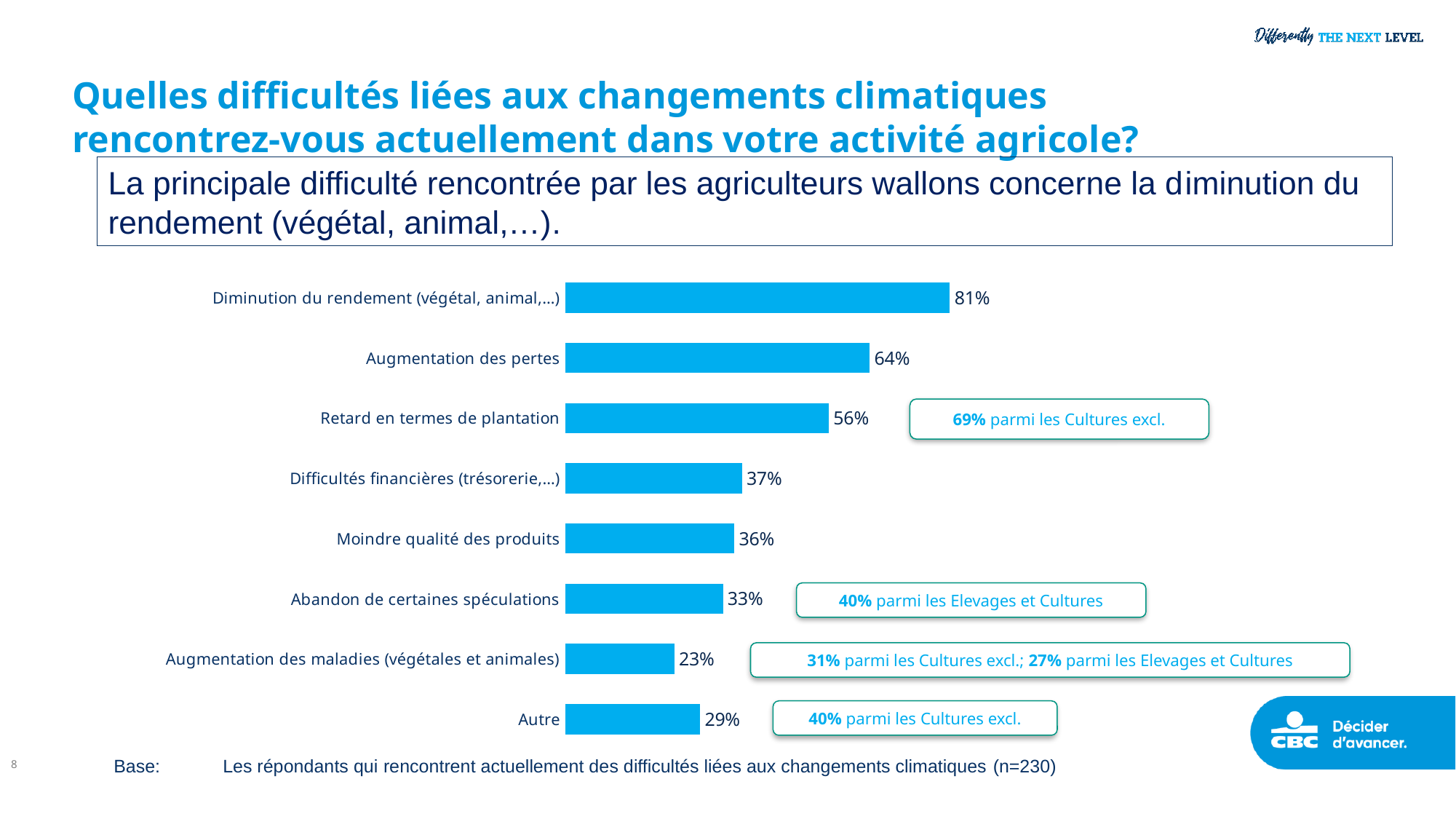
What is the value for "Diminution du rendement (végétal, animal,…)"? 81% Which category has the highest value? Diminution du rendement (végétal, animal,…) What is the difference between the values for "Diminution du rendement (végétal, animal,…)" and "Augmentation des pertes"? 17% What is the value for "Retard en termes de plantation"? 56% Which category has the lowest value? Augmentation des maladies (végétales et animales) According to the annotation next to "Retard en termes de plantation", what is the value among "Cultures excl."? 69% Which is larger, the value for "Autre" or the value for "Augmentation des maladies (végétales et animales)"? Autre What is the value for "Augmentation des pertes"? 64% What kind of chart is shown on the slide? Bar chart What is the value for "Moindre qualité des produits"? 36% How many categories are shown in the chart? 8 What is the value for "Augmentation des maladies (végétales et animales)"? 23%